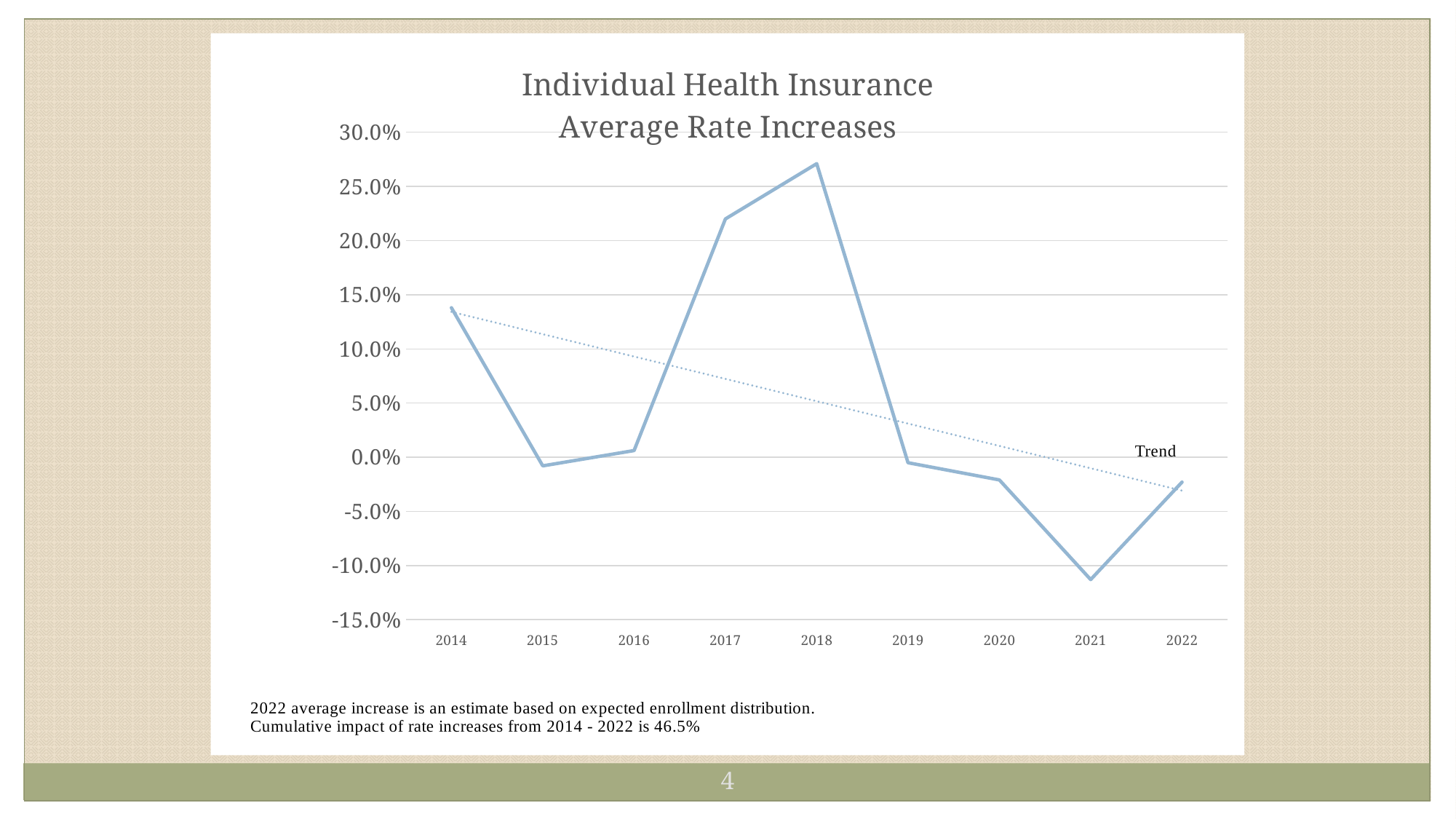
Is the value for 2014 greater or less than 10.0%? greater Is the value for 2021 greater or less than -10.0%? less Is the value for 2020 greater or less than 0.0%? less What is the title of the chart? Individual Health Insurance Average Rate Increases How many years are plotted on the x axis? 9 Which year has the highest average rate increase? 2018 Which year has the larger average rate increase, 2014 or 2017? 2017 What kind of chart is shown on the slide? line chart Do the values rise or fall from 2018 to 2021? fall Which year has the lowest average rate increase? 2021